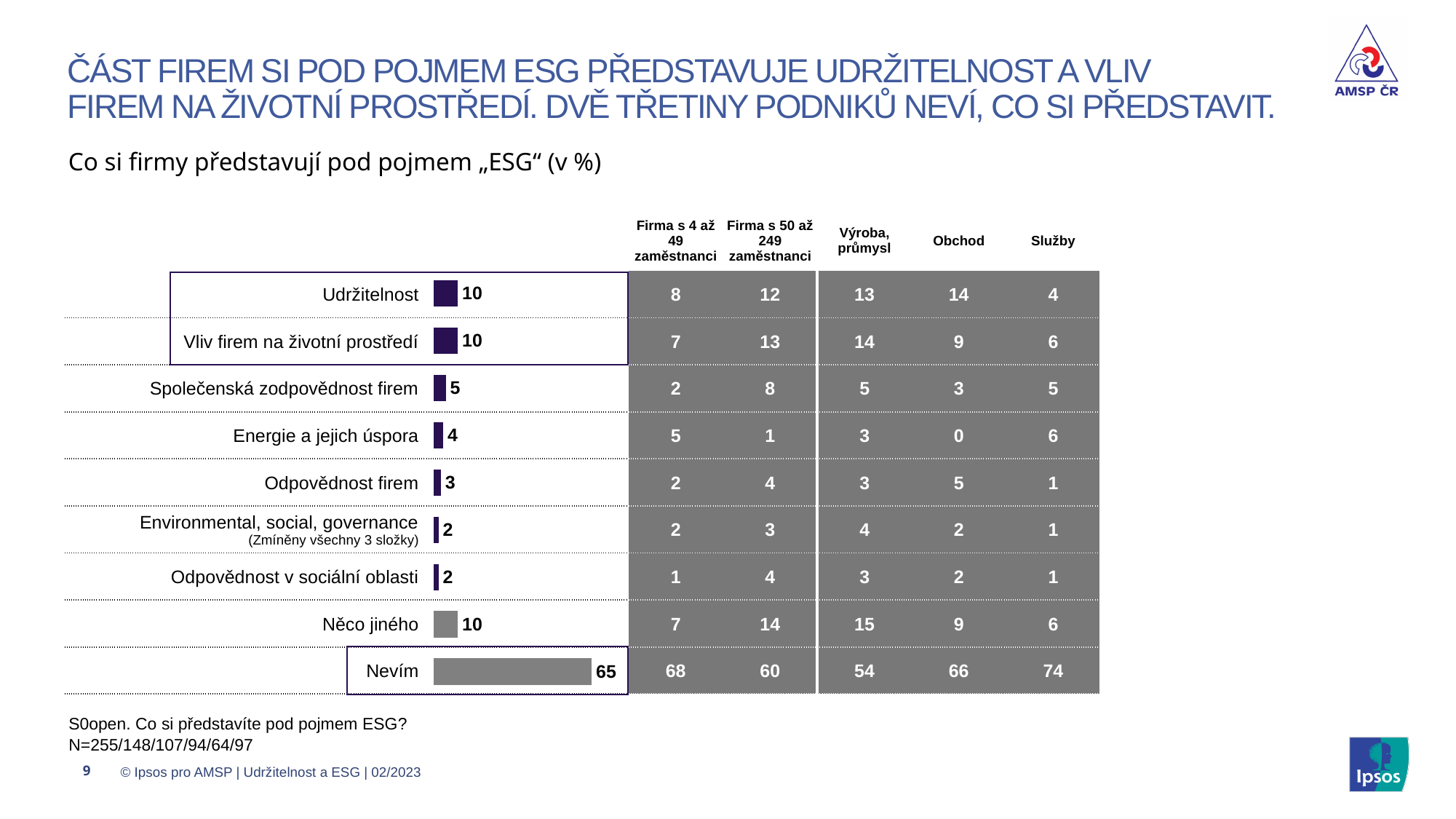
What is the difference between the values for "Nevím" and "Něco jiného" in the bar chart? 55 What is the subtitle of the chart on the slide? Co si firmy představují pod pojmem „ESG“ (v %) How many categories are shown in the bar chart? 9 What is the value for "Udržitelnost" in the bar chart? 10 What kind of chart is shown on the slide? bar chart Which is larger in the bar chart: the value for "Společenská zodpovědnost firem" or for "Energie a jejich úspora"? Společenská zodpovědnost firem What is the value for "Odpovědnost firem" in the bar chart? 3 What is the value for "Nevím" in the bar chart? 65 What is the value for "Společenská zodpovědnost firem" in the bar chart? 5 What is the value for "Energie a jejich úspora" in the bar chart? 4 Which category has the highest value in the bar chart? Nevím What is the difference between the values for "Společenská zodpovědnost firem" and "Odpovědnost firem" in the bar chart? 2